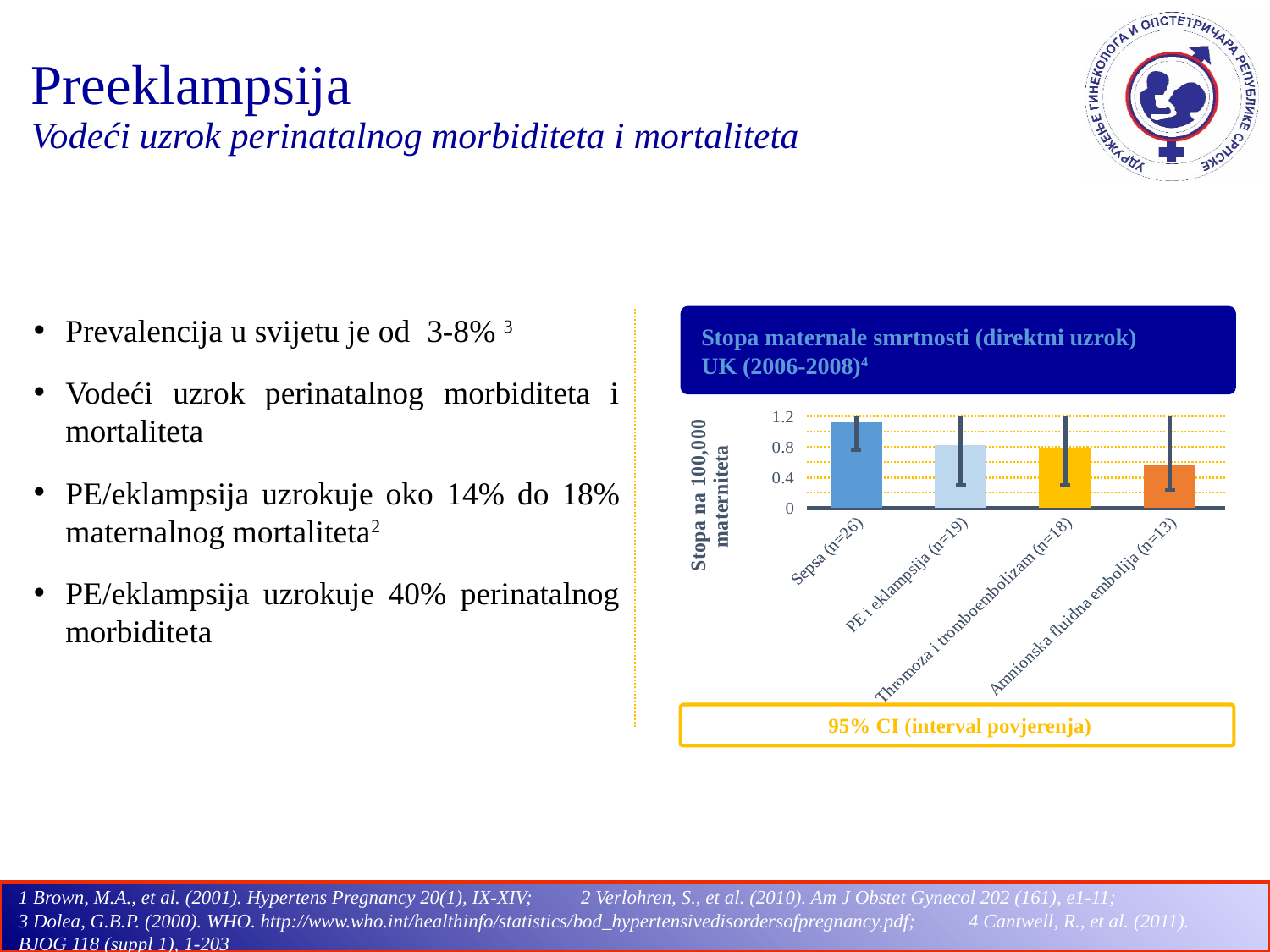
What is the label of the vertical axis of the chart? Stopa na 100,000 materniteta Which is larger, the value for Sepsa (n=26) or the value for Amnionska fluidna embolija (n=13)? Sepsa (n=26) How many categories are plotted in the chart? 4 Which category has the lowest maternal mortality rate in the chart? Amnionska fluidna embolija (n=13) Is the value for Sepsa (n=26) greater or less than 0.8? greater What is the title of the chart? Stopa maternale smrtnosti (direktni uzrok) UK (2006-2008) Is the value for Amnionska fluidna embolija (n=13) greater or less than 0.8? less Which category has the highest maternal mortality rate in the chart? Sepsa (n=26) What kind of chart is shown on the slide? bar chart Is the value for Amnionska fluidna embolija (n=13) greater or less than 0.4? greater Do the bar values rise or fall from left to right across the categories? fall